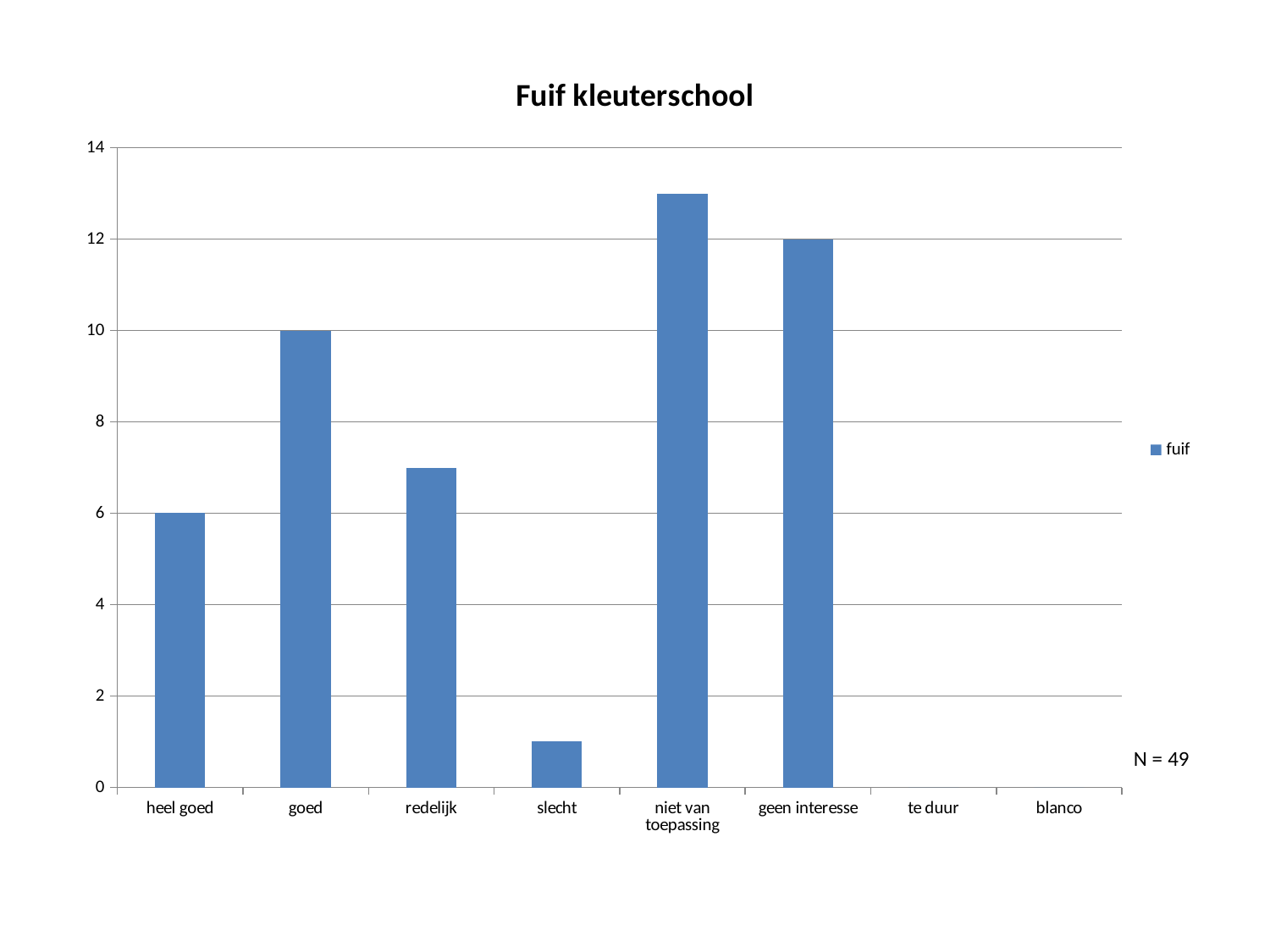
Which is larger, the value for goed or the value for redelijk? goed What kind of chart is this? bar chart Is the value for niet van toepassing greater or less than 12? greater Which category has the highest value? niet van toepassing What is the value for goed? 10 What is the value for geen interesse? 12 Is the value for slecht greater or less than 2? less What is the value for te duur? 0 How many categories are shown on the x axis? 8 What is the difference between the values for goed and heel goed? 4 What is the value for heel goed? 6 What is the title of the chart? Fuif kleuterschool